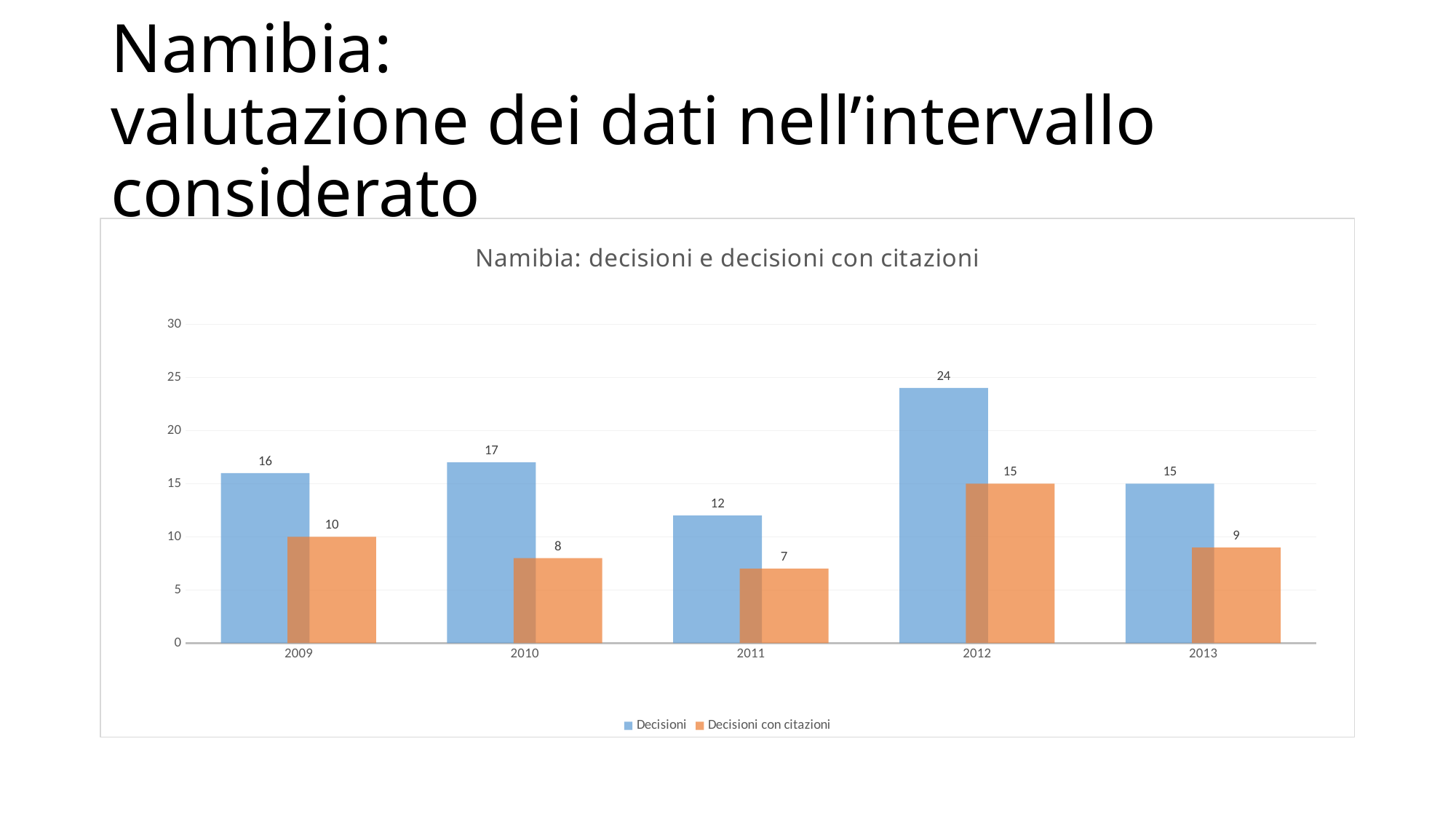
What kind of chart is shown on the slide? Bar chart What is the value of Decisioni con citazioni for 2013? 9 Which is larger: Decisioni con citazioni in 2009 or in 2013? 2009 How many series does the legend list? 2 What is the value of Decisioni for 2012? 24 Is the value of Decisioni for 2012 greater or less than 20? greater Which year has the lowest value for Decisioni con citazioni? 2011 What is the value of Decisioni con citazioni for 2011? 7 What is the difference between Decisioni and Decisioni con citazioni in 2010? 9 What is the title of the chart? Namibia: decisioni e decisioni con citazioni How many years are shown on the x axis? 5 Which year has the highest value for Decisioni? 2012